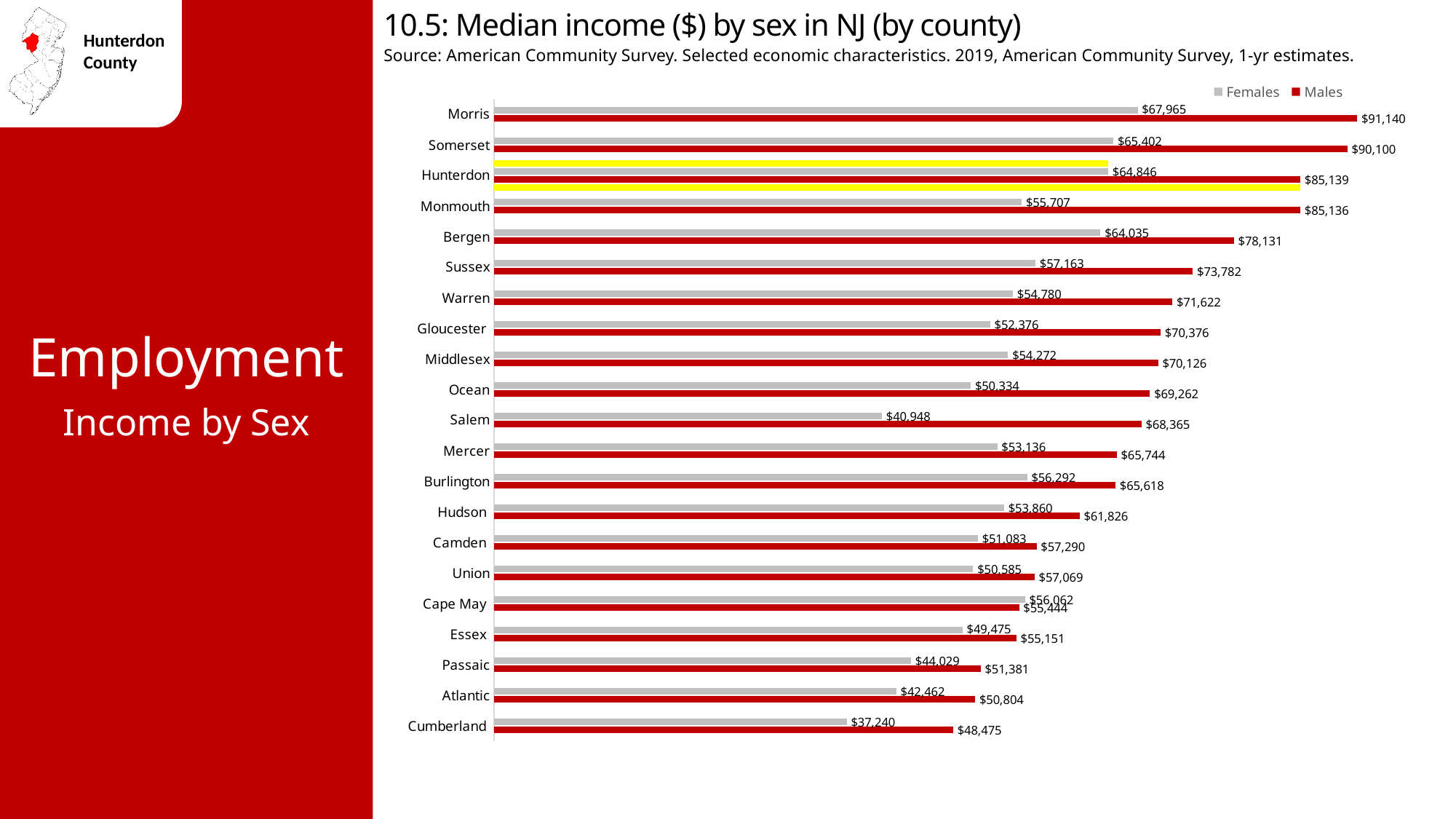
What is the difference between the male median incomes of Hunterdon and Monmouth counties? $3 What is the median income for females in Cumberland County? $37,240 Which county has the lowest median income for females? Cumberland In Cape May County, which is higher: the female or the male median income? Females How many series does the legend list? 2 How many counties are shown in the chart? 21 What is the median income for females in Salem County? $40,948 What is the difference between the male and female median incomes in Morris County? $23,175 What type of chart is shown on the slide? Bar chart Which county has the highest median income for females? Morris What is the median income for males in Hunterdon County? $85,139 Which county has the highest median income for males? Morris